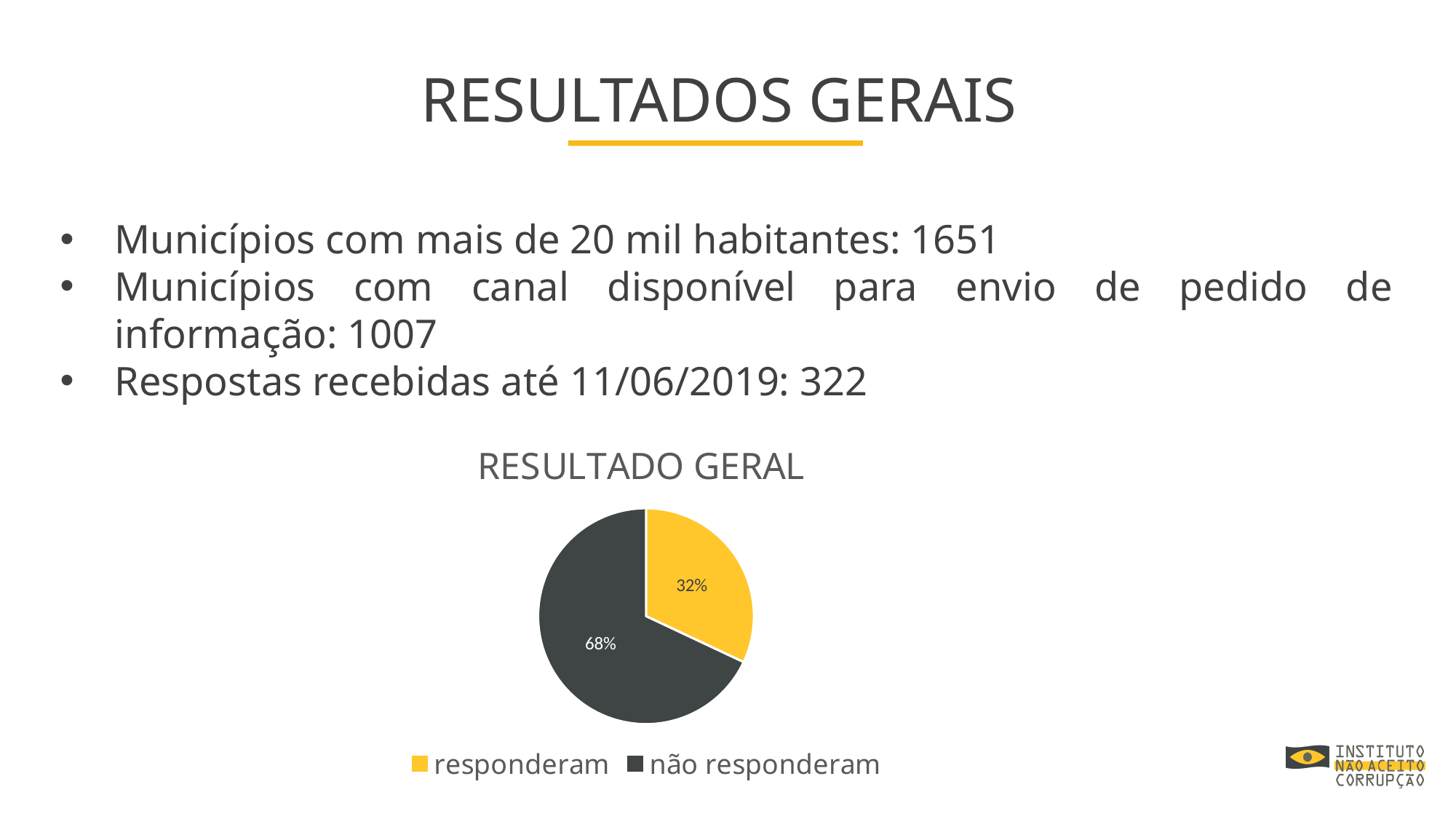
How many slices does the pie chart have? 2 What is the difference in percentage points between "não responderam" and "responderam"? 36 What type of chart is shown on the slide? pie chart What percentage of the pie is labelled "responderam"? 32% What percentage of the pie is labelled "não responderam"? 68% How many entries does the legend list? 2 Which is larger, the "responderam" slice or the "não responderam" slice? não responderam What is the title of the chart? RESULTADO GERAL What colour is the "responderam" slice? yellow Which slice of the pie is the largest? não responderam Which slice of the pie is the smallest? responderam What share of the pie does the "não responderam" slice represent? 68%